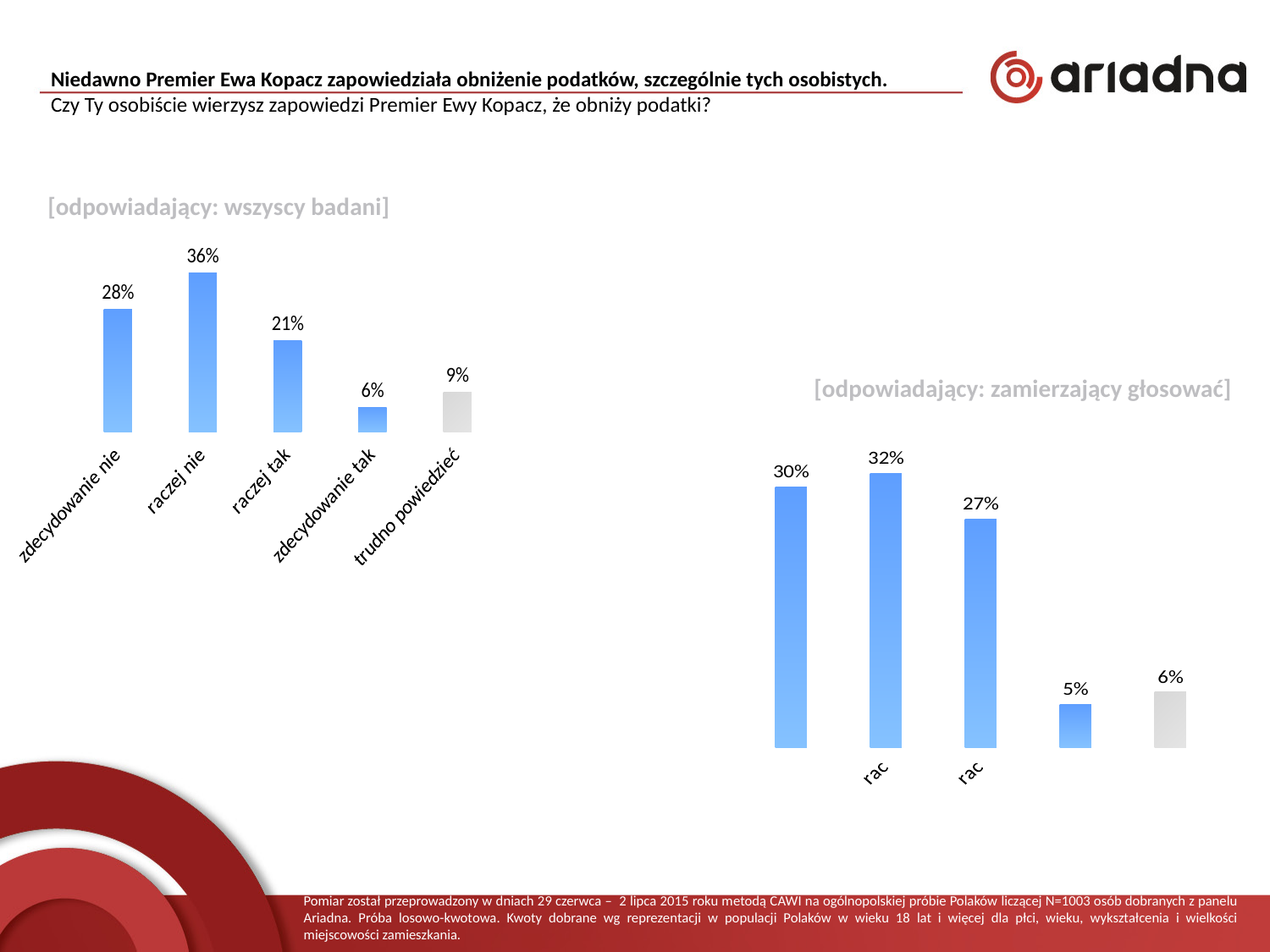
What kind of chart is the chart titled "[odpowiadający: zamierzający głosować]"? bar chart In the chart titled "[odpowiadający: wszyscy badani]", what is the value for "trudno powiedzieć"? 9% In the chart titled "[odpowiadający: wszyscy badani]", which category has the highest value? raczej nie In the chart titled "[odpowiadający: zamierzający głosować]", what is the difference between the first bar (30%) and the third bar (27%)? 3 percentage points In the chart titled "[odpowiadający: wszyscy badani]", what is the value for "zdecydowanie tak"? 6% In the chart titled "[odpowiadający: wszyscy badani]", what is the difference between "zdecydowanie nie" and "raczej tak"? 7 percentage points In the chart titled "[odpowiadający: zamierzający głosować]", what is the value of the second bar from the left? 32% In the chart titled "[odpowiadający: wszyscy badani]", which is larger: "zdecydowanie nie" or "raczej tak"? zdecydowanie nie In the chart titled "[odpowiadający: wszyscy badani]", what is the value for "raczej nie"? 36% How many categories does the chart titled "[odpowiadający: wszyscy badani]" show? 5 In the chart titled "[odpowiadający: wszyscy badani]", which category has the lowest value? zdecydowanie tak In the chart titled "[odpowiadający: zamierzający głosować]", what is the lowest value shown? 5%